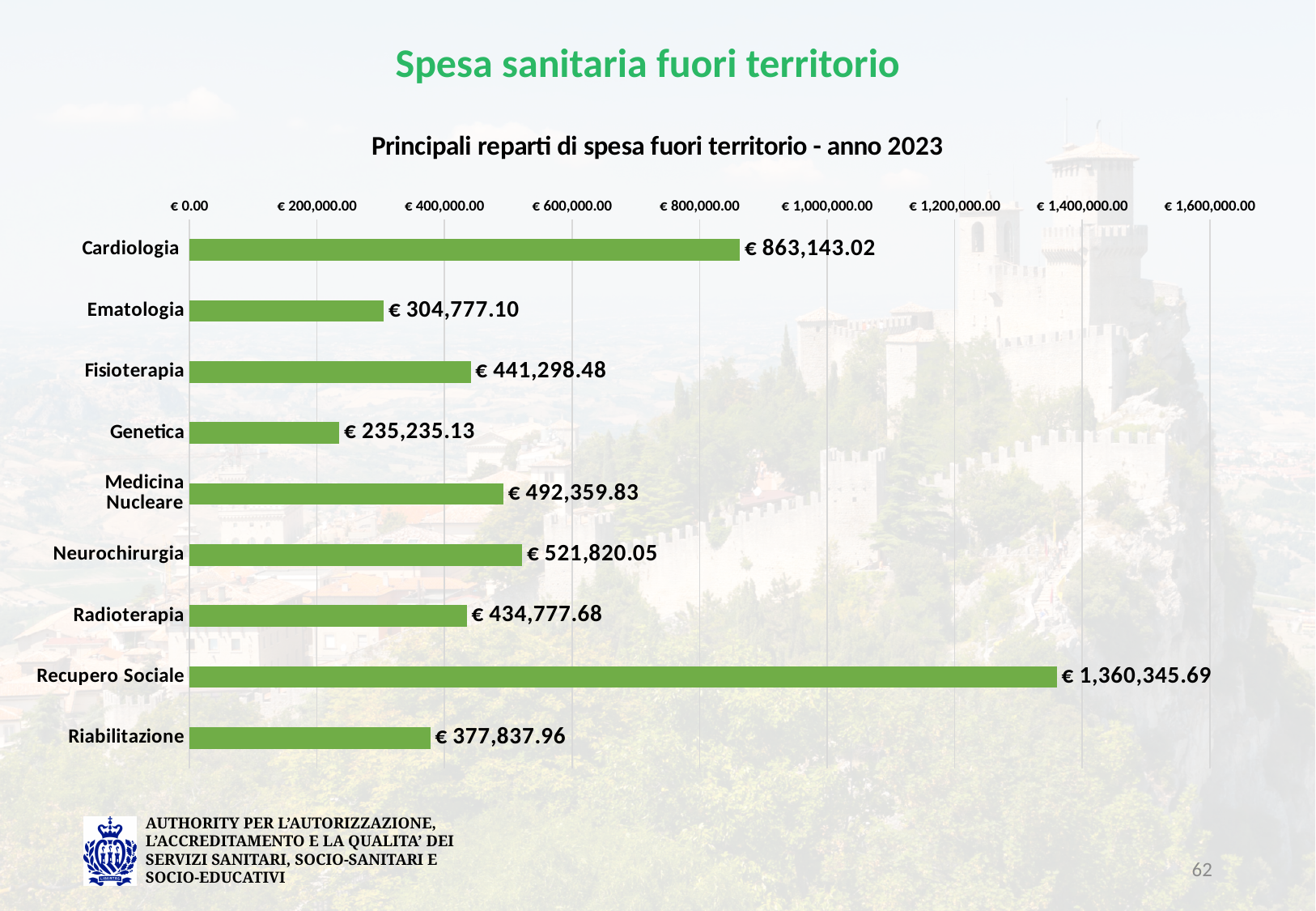
What is the difference between the values for Recupero Sociale and Cardiologia? € 497,202.67 Is the value for Cardiologia greater or less than € 800,000.00? greater Which category has the highest value? Recupero Sociale What is the value for Cardiologia? € 863,143.02 Which is larger, the value for Ematologia or the value for Riabilitazione? Riabilitazione What is the difference between the values for Neurochirurgia and Medicina Nucleare? € 29,460.22 What is the value for Riabilitazione? € 377,837.96 What is the value for Medicina Nucleare? € 492,359.83 How many categories are shown in the chart? 9 What kind of chart is shown on the slide? Bar chart Which category has the lowest value? Genetica What is the title of the chart? Principali reparti di spesa fuori territorio - anno 2023